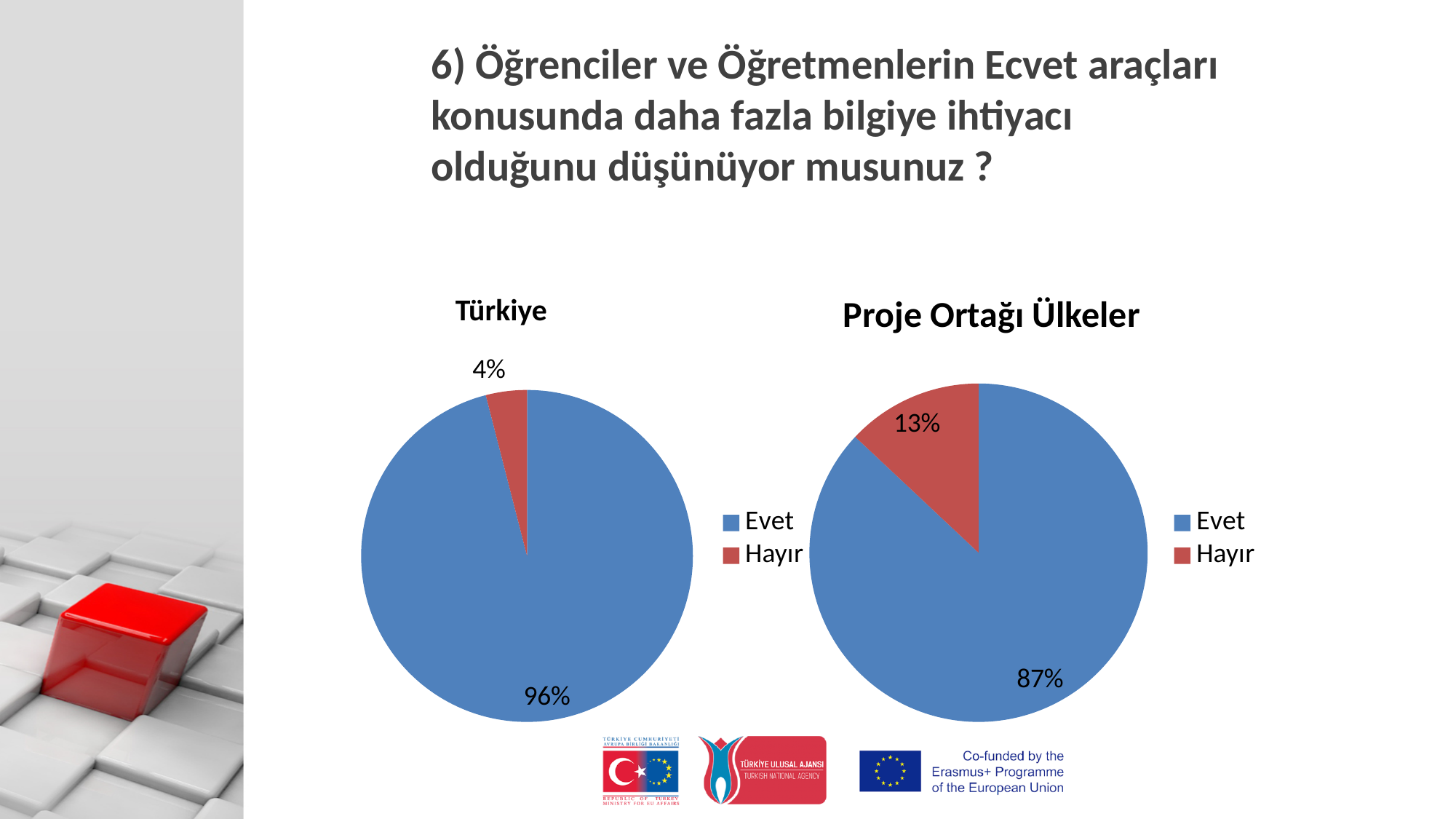
In the Proje Ortağı Ülkeler chart, which slice is the smallest? Hayır In the Türkiye chart, what share of the pie is Hayır? 4% What colour is the Evet slice in the Türkiye chart? Blue In the Proje Ortağı Ülkeler chart, what share of the pie is Evet? 87% Which chart has the larger Hayır share, Türkiye or Proje Ortağı Ülkeler? Proje Ortağı Ülkeler In the Proje Ortağı Ülkeler chart, what share of the pie is Hayır? 13% What is the difference between the Evet and Hayır shares in the Türkiye chart? 92% How many slices does the Proje Ortağı Ülkeler chart have? 2 What kind of chart is the Türkiye chart? Pie chart In the Türkiye chart, which slice is the largest? Evet What is the difference between the Hayır share in the Proje Ortağı Ülkeler chart and the Hayır share in the Türkiye chart? 9%